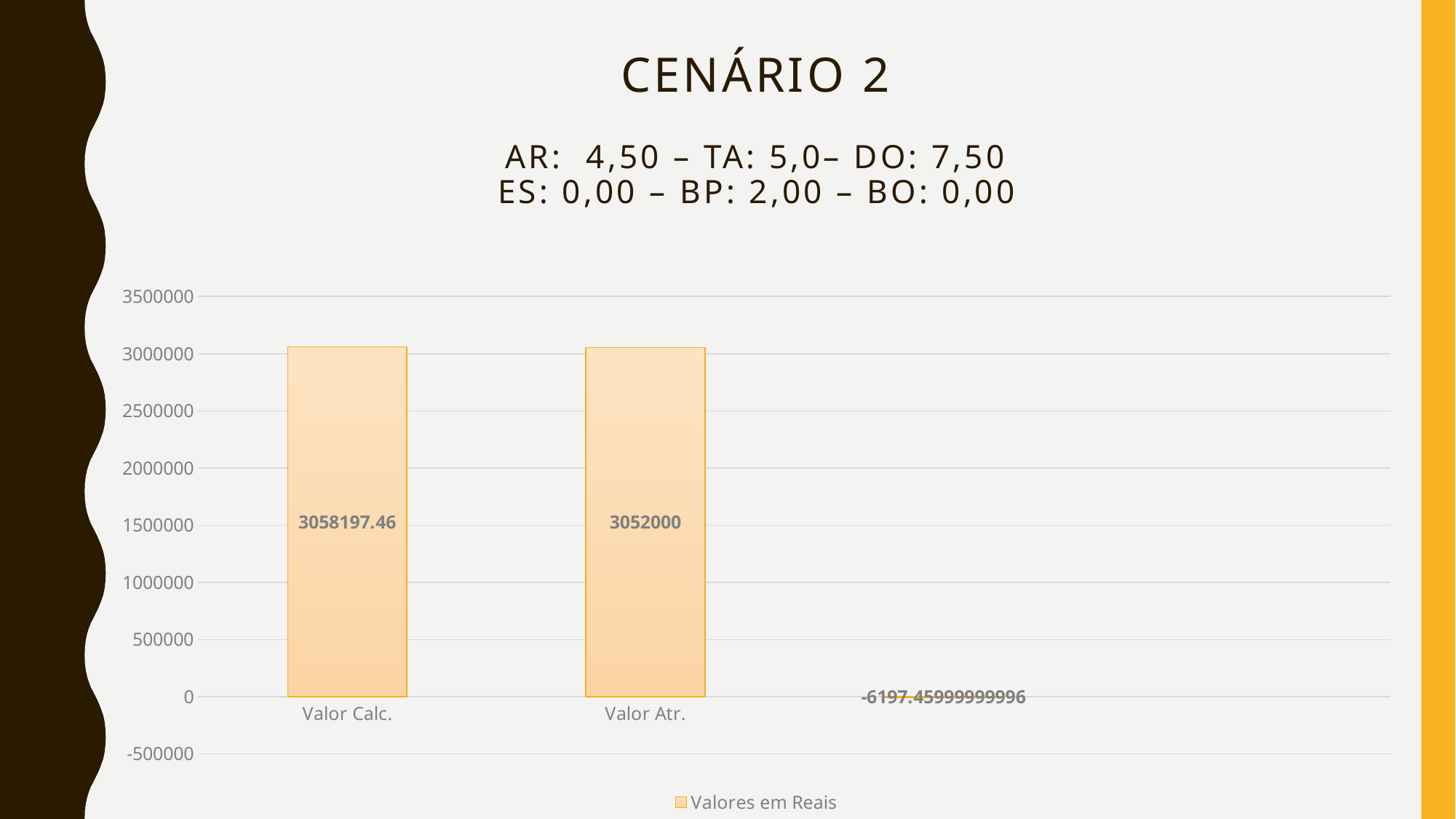
What kind of chart is shown on the slide? bar chart What is the value for Valor Atr.? 3052000 Is the value for Valor Atr. greater or less than 3500000? less Is the value for Valor Calc. greater or less than 3000000? greater What is the difference between the values for Valor Calc. and Valor Atr.? 6197.46 What is the title of the slide containing the chart? CENÁRIO 2 What is the value for Valor Calc.? 3058197.46 Which category has the highest value, Valor Calc. or Valor Atr.? Valor Calc. Is the value for Valor Atr. larger or smaller than the value for Valor Calc.? smaller What is the legend entry of the chart? Valores em Reais How many bars rise above zero in the chart? 2 How many series does the legend list? 1